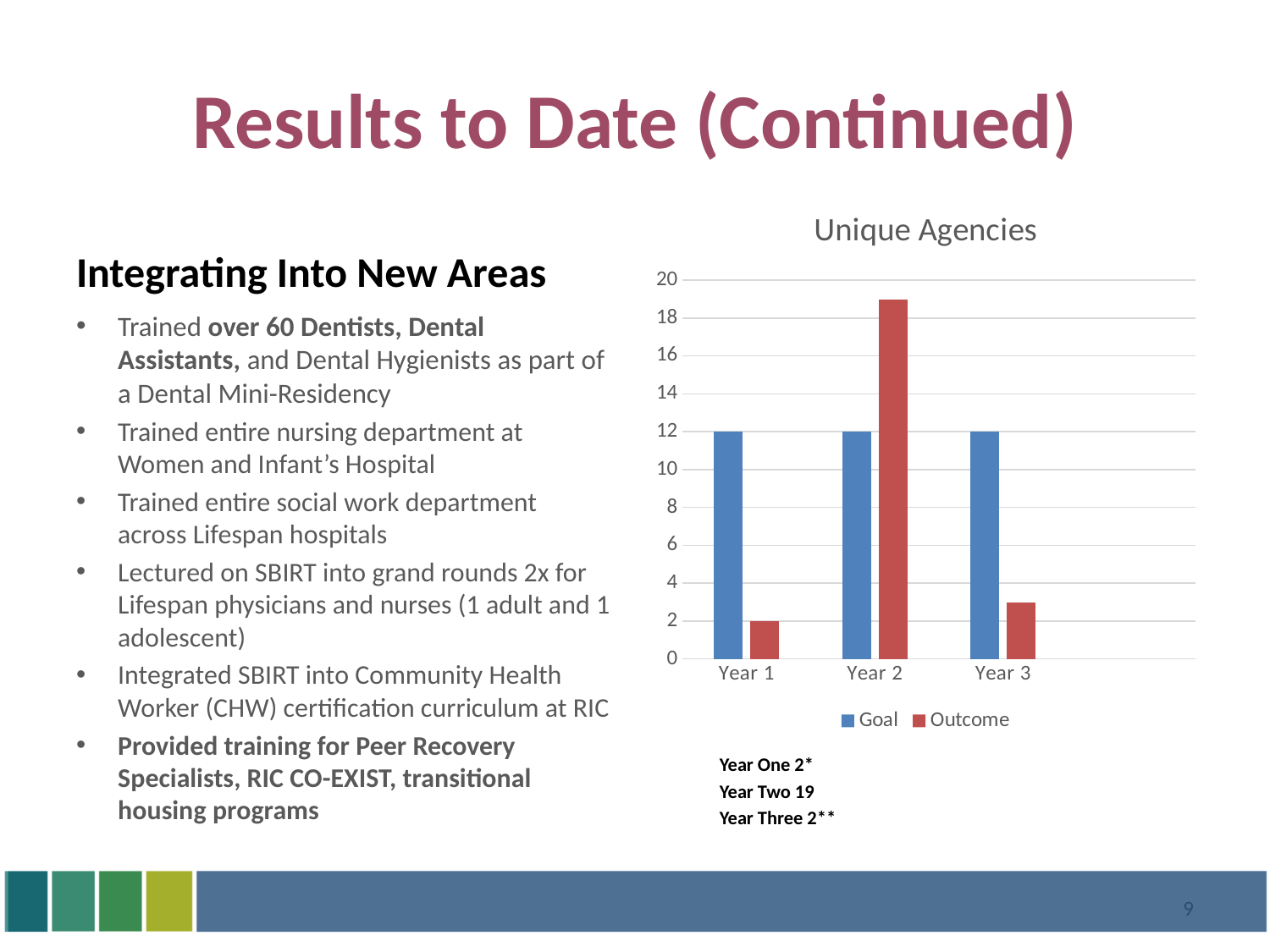
Is the Outcome value for Year 2 greater or less than 18? greater What kind of chart is shown on the slide? Bar chart What is the Goal value for Year 1? 12 For Year 2, which is larger, the Goal or the Outcome? Outcome Which year has the highest Outcome value? Year 2 What is the title of the chart? Unique Agencies Is the Outcome value for Year 3 greater or less than 4? less What is the difference between the Goal and the Outcome for Year 1? 10 What is the Goal value for Year 3? 12 How many categories are shown on the x axis of the chart? 3 What is the Outcome value for Year 1? 2 How many series does the chart's legend list? 2